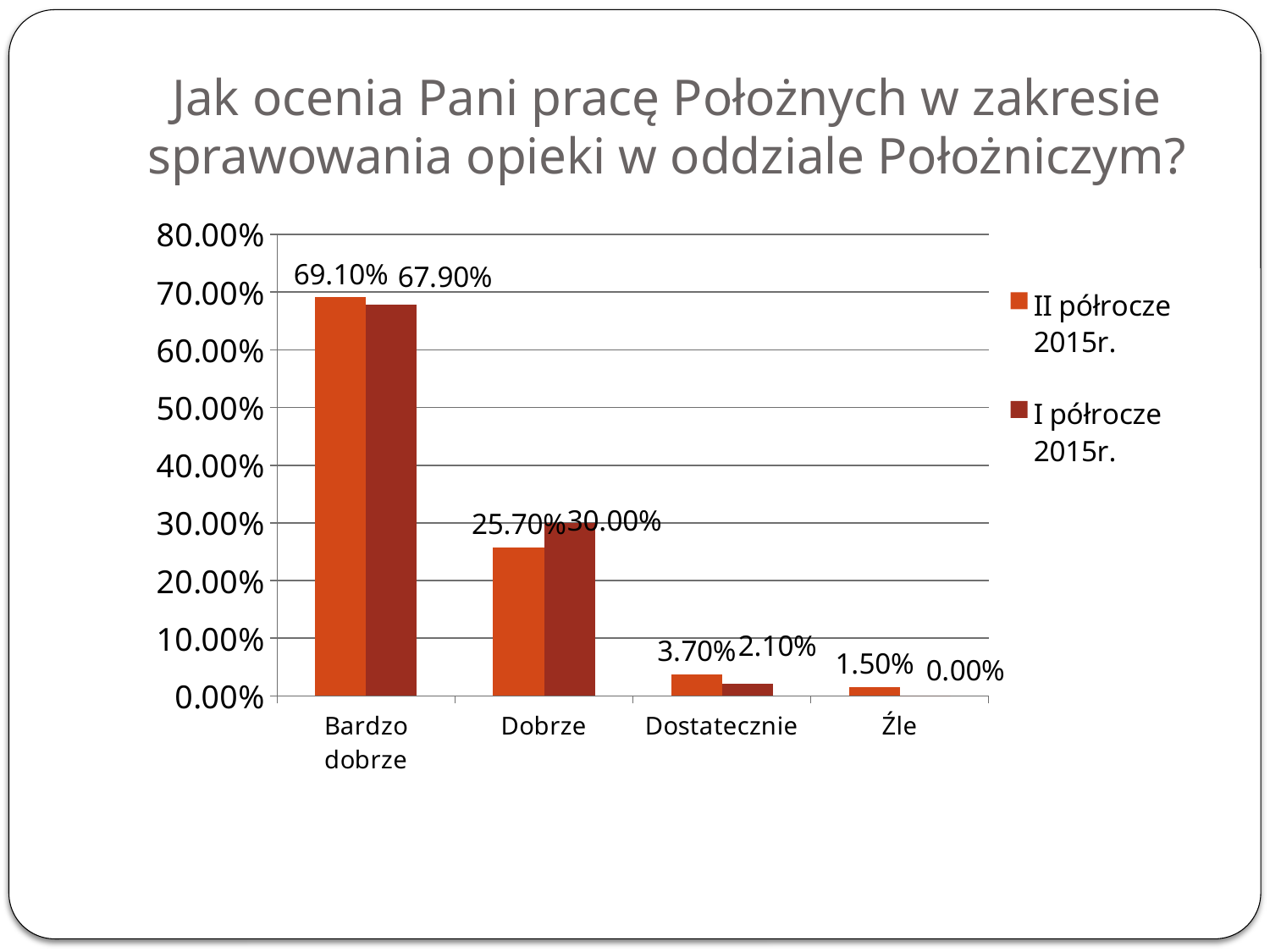
What is the value for "Dobrze" in the "I półrocze 2015r." series? 30.00% Which category has the highest value in the "II półrocze 2015r." series? Bardzo dobrze How many categories are shown on the x axis? 4 What is the value for "Bardzo dobrze" in the "II półrocze 2015r." series? 69.10% What is the difference between the "I półrocze 2015r." and "II półrocze 2015r." values for "Dobrze"? 4.30% Do the values in the "II półrocze 2015r." series rise or fall from left to right along the x axis? Fall For "Dostatecznie", which series has the larger value: "II półrocze 2015r." or "I półrocze 2015r."? II półrocze 2015r. How many series does the legend list? 2 What kind of chart is shown on the slide? Bar chart What is the value for "Źle" in the "I półrocze 2015r." series? 0.00% Which category has the lowest value in the "I półrocze 2015r." series? Źle What is the value for "Dostatecznie" in the "II półrocze 2015r." series? 3.70%